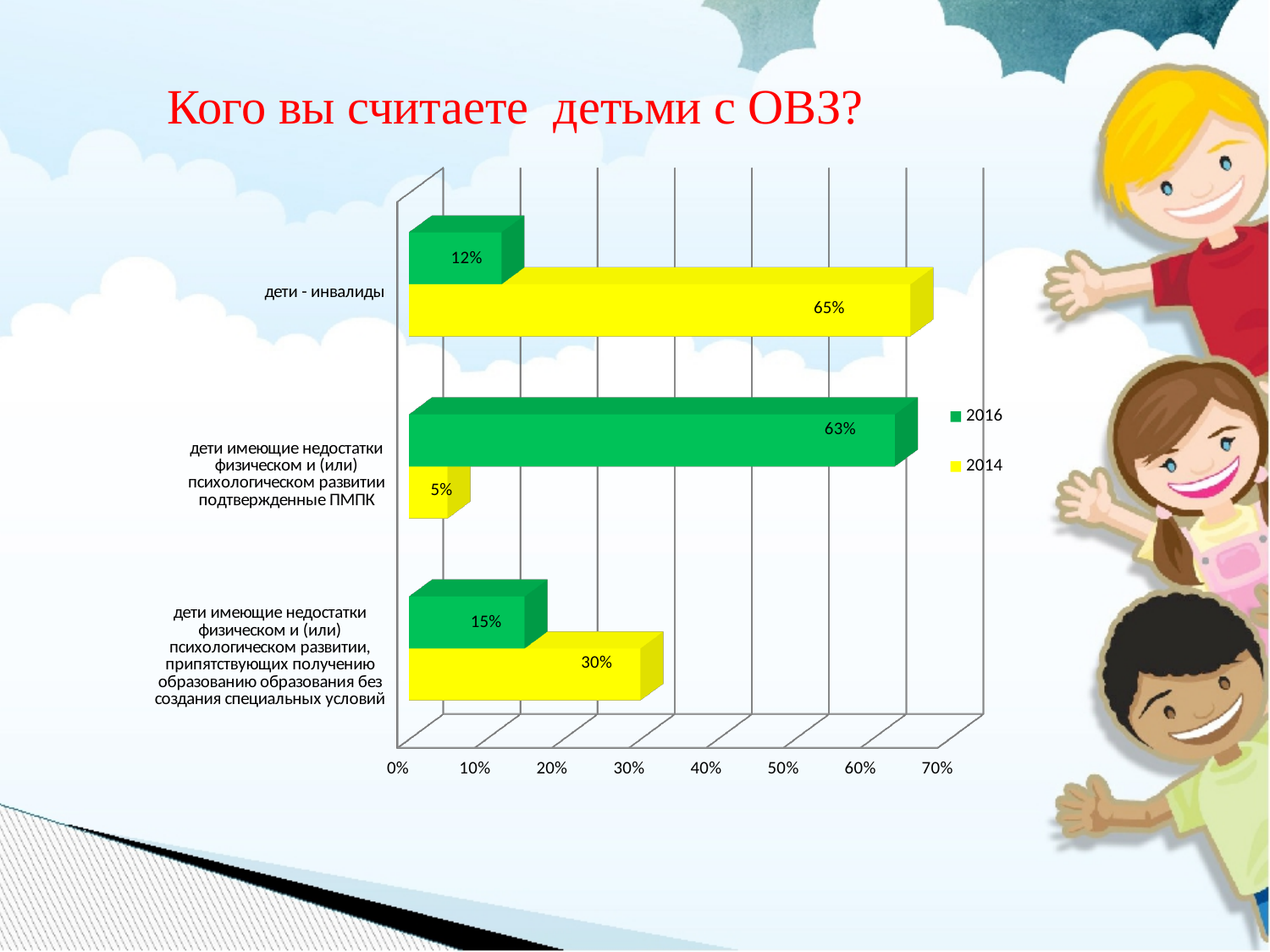
What is the 2016 value for "дети имеющие недостатки физическом и (или) психологическом развитии подтвержденные ПМПК"? 63% What is the 2016 value for "дети - инвалиды"? 12% How many series does the legend list? 2 Which colour represents the 2016 series in the legend? green What is the difference between the 2014 and 2016 values for "дети - инвалиды"? 53% For the category "дети имеющие недостатки физическом и (или) психологическом развитии, припятствующих получению образованию образования без создания специальных условий", which year has the larger value, 2014 or 2016? 2014 What is the 2014 value for "дети имеющие недостатки физическом и (или) психологическом развитии, припятствующих получению образованию образования без создания специальных условий"? 30% Which category has the lowest 2014 value? дети имеющие недостатки физическом и (или) психологическом развитии подтвержденные ПМПК What type of chart is shown on the slide? bar chart Which category has the highest 2016 value? дети имеющие недостатки физическом и (или) психологическом развитии подтвержденные ПМПК How many categories are shown on the chart? 3 What is the 2014 value for "дети - инвалиды"? 65%